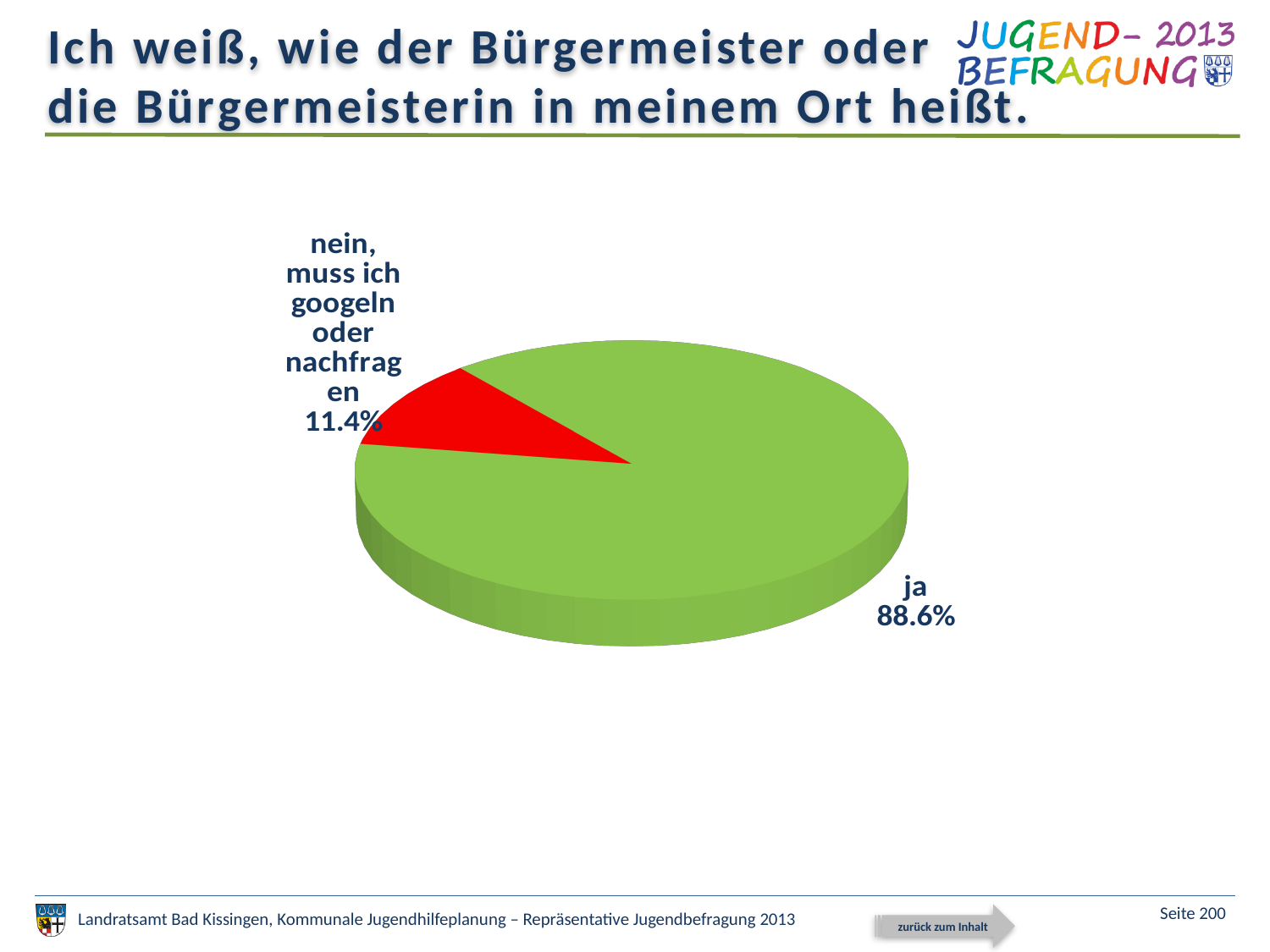
What is the difference in percentage points between the "ja" slice and the "nein, muss ich googeln oder nachfragen" slice? 77.2 percentage points What colour is the "ja" slice of the pie? Green How many slices does the pie chart have? 2 Which slice of the pie is the smallest? nein, muss ich googeln oder nachfragen What is the total of the two pie slice percentages? 100% What share of the pie is labelled "ja"? 88.6% What kind of chart is shown on the slide? Pie chart Is the share for "ja" greater or less than 50%? greater What colour is the "nein, muss ich googeln oder nachfragen" slice of the pie? Red Which is larger: the "ja" slice or the "nein, muss ich googeln oder nachfragen" slice? ja Which slice of the pie is the largest? ja What share of the pie is labelled "nein, muss ich googeln oder nachfragen"? 11.4%